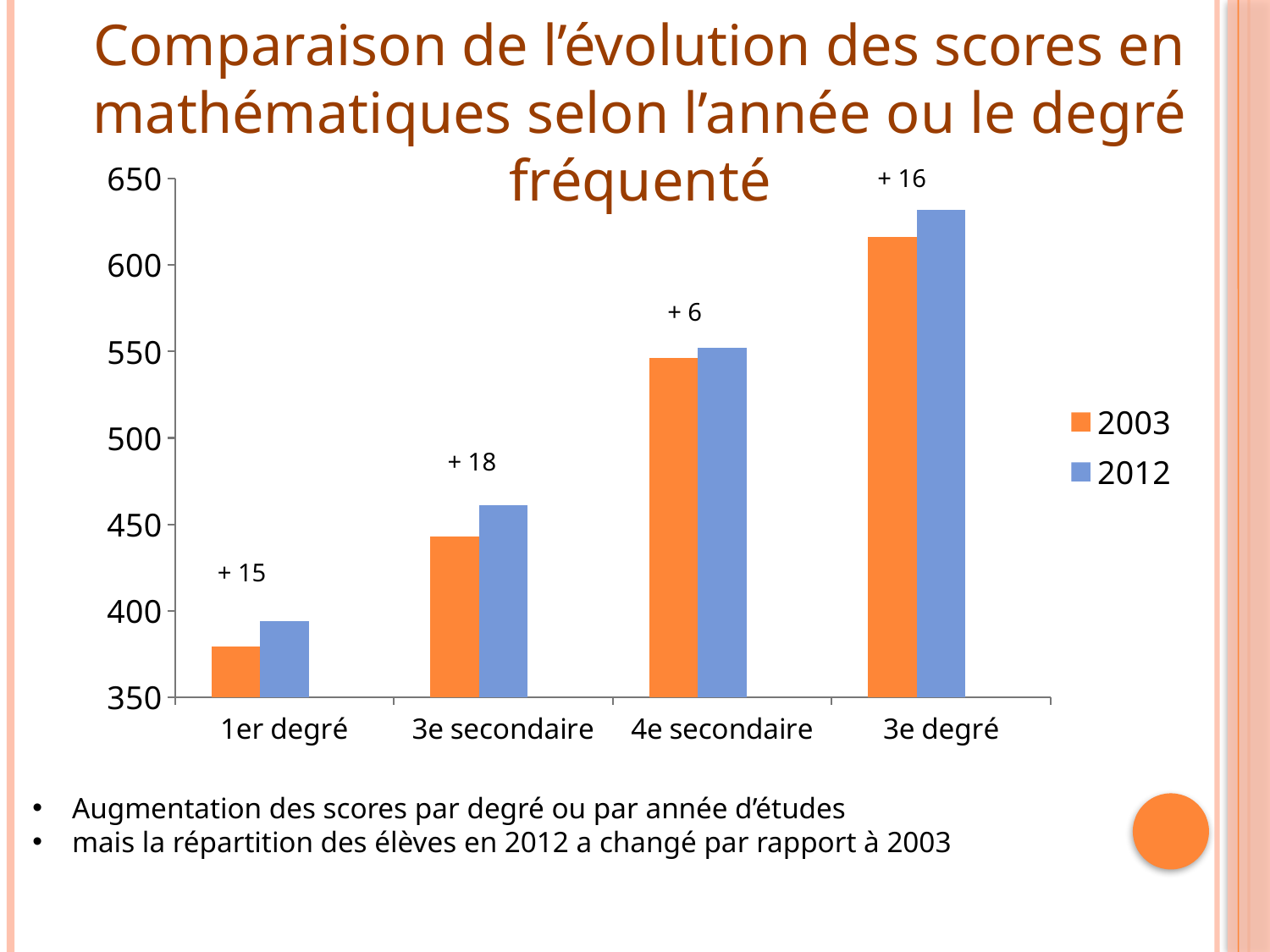
Is the 2003 value for 1er degré greater or less than 400? less Is the 2012 value for 3e degré greater or less than 600? greater Do the scores rise or fall from 1er degré to 3e degré along the x axis? rise What increase is labelled above the bars for 4e secondaire? + 6 What increase is labelled above the bars for 3e secondaire? + 18 Which category has the highest 2012 score? 3e degré How many categories are shown on the x axis of the chart? 4 Which category has the smallest labelled increase between 2003 and 2012? 4e secondaire What kind of chart is shown on the slide? bar chart How many series does the legend list? 2 Which category has the lowest 2003 score? 1er degré What are the two series listed in the legend? 2003 and 2012